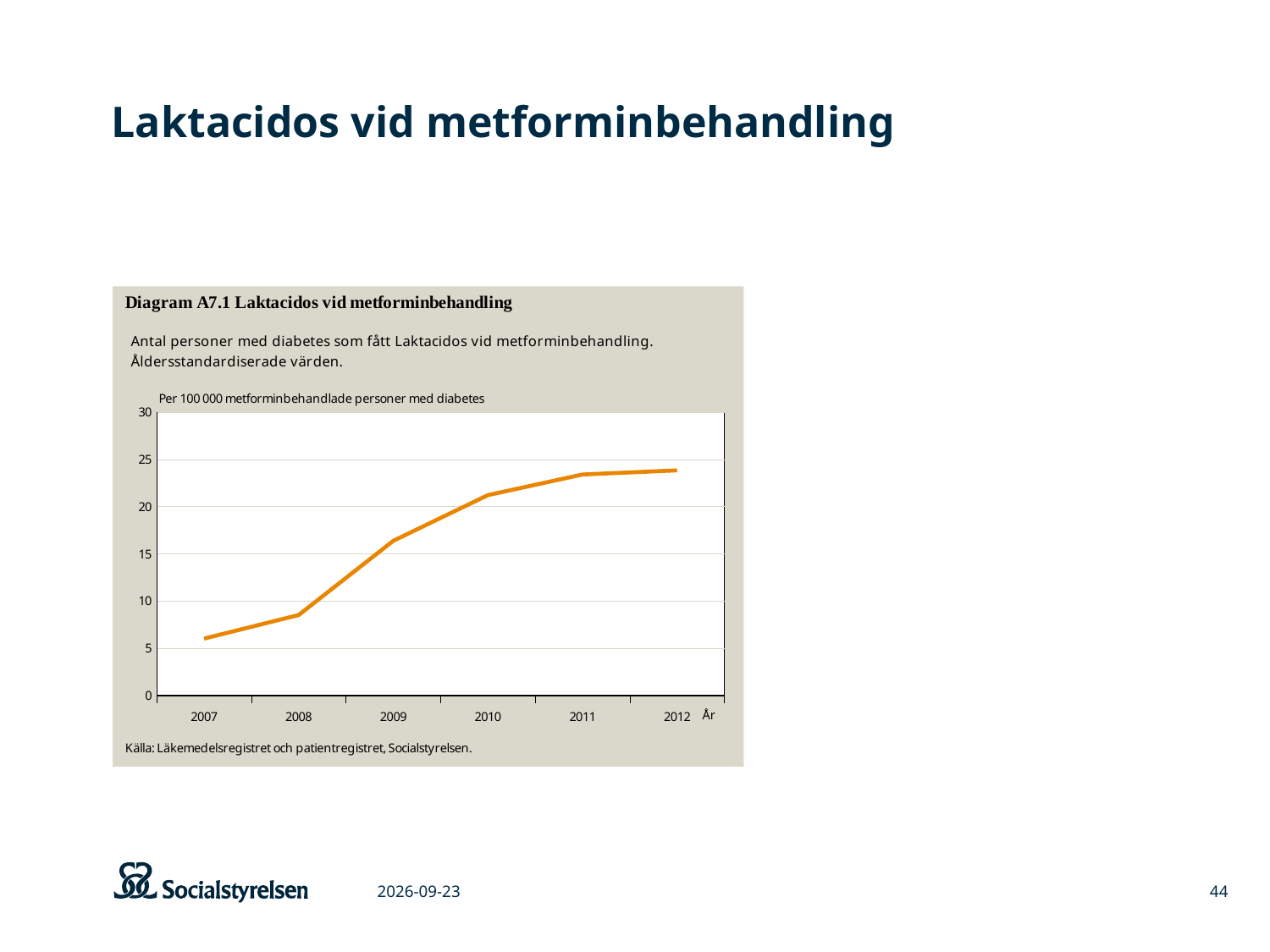
Is the value for 2012 greater or less than 25? less How many years are plotted on the x axis of the chart? 6 What kind of chart is shown in Diagram A7.1? line chart Which year has the lowest value in the chart? 2007 Do the values in the chart rise or fall from 2007 to 2012? rise Is the value for 2008 greater or less than 10? less Which is larger, the value for 2009 or the value for 2008? 2009 Is the value for 2009 greater or less than 15? greater What unit is given on the y axis of the chart? Per 100 000 metforminbehandlade personer med diabetes What is the title of the diagram on the slide? Diagram A7.1 Laktacidos vid metforminbehandling